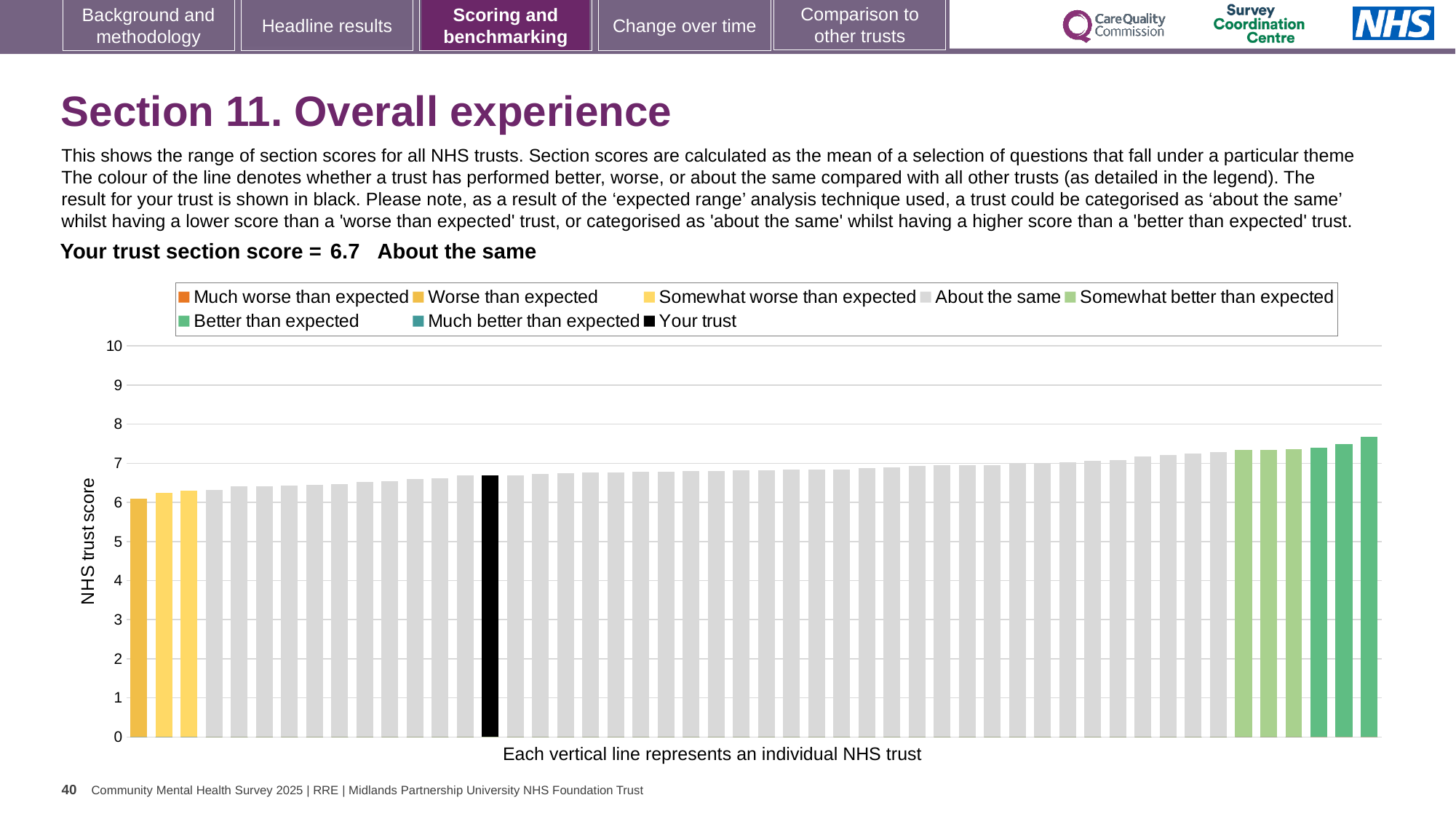
How many entries does the chart legend list? 8 Is the value for the rightmost bar greater or less than 7? greater What is the label on the vertical axis of the chart? NHS trust score How is your trust's section score categorised compared with other trusts? About the same What is the section score for your trust shown on the slide? 6.7 Is the value for the leftmost bar greater or less than 7? less What colour is the bar representing your trust in the chart? black What is the highest value shown on the vertical axis? 10 Is the value for the black 'Your trust' bar greater or less than 6? greater Do the bar values rise or fall from left to right along the x axis? rise What type of chart is shown on the slide? bar chart Which bar is taller, the leftmost bar or the rightmost bar? the rightmost bar